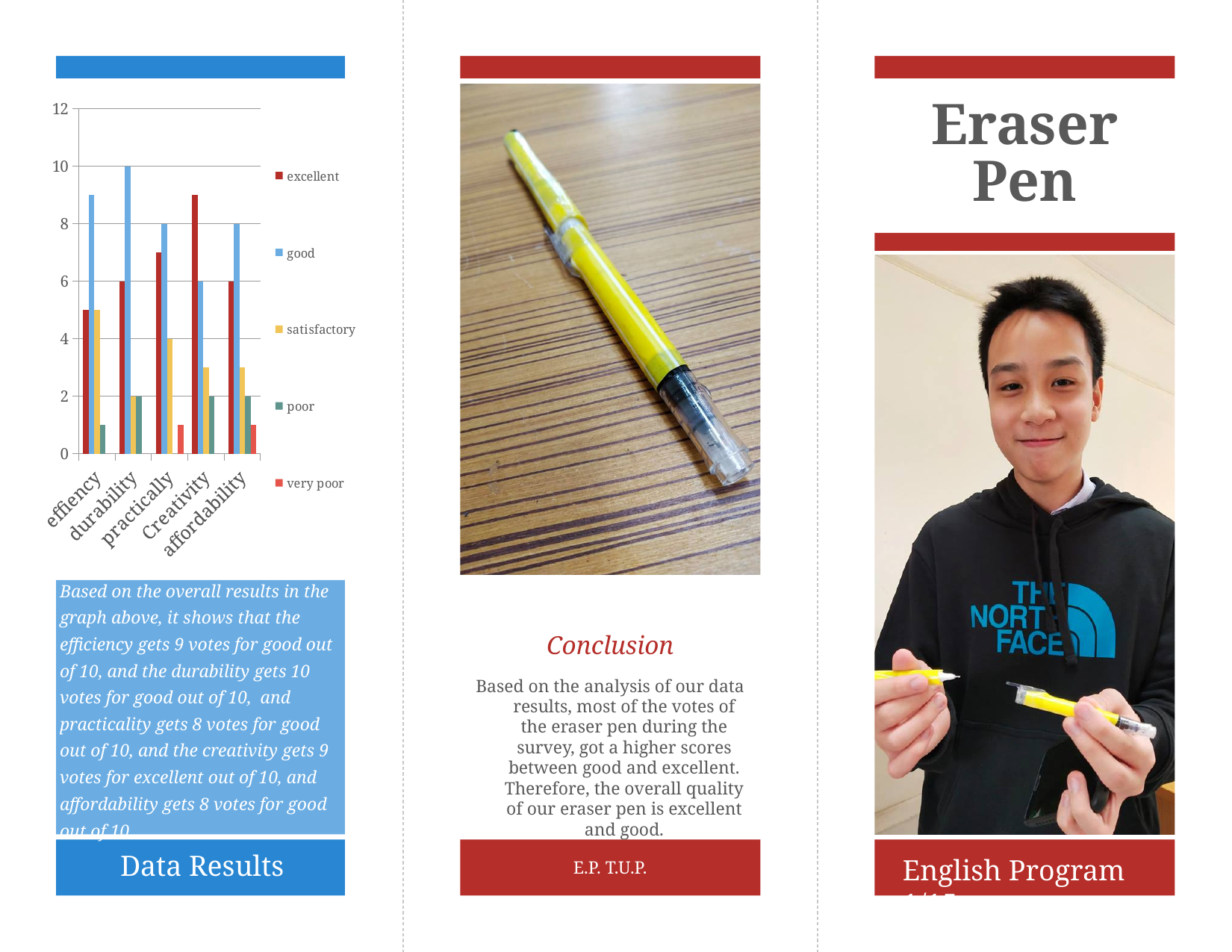
What kind of chart is shown on the slide? bar chart What is the value of the 'good' bar for durability? 10 What is the value of the 'good' bar for practically? 8 Which category has the highest 'good' bar? durability How many series does the chart's legend list? 5 What colour represents the 'good' series in the chart's legend? blue Is the 'excellent' value for Creativity greater or less than 8? greater For durability, which is larger: the 'good' bar or the 'excellent' bar? good How many categories are shown along the x axis of the chart? 5 Is the 'excellent' value for effiency greater or less than 6? less What is the difference between the 'good' value for durability and the 'good' value for practically? 2 For Creativity, which is larger: the 'excellent' bar or the 'good' bar? excellent